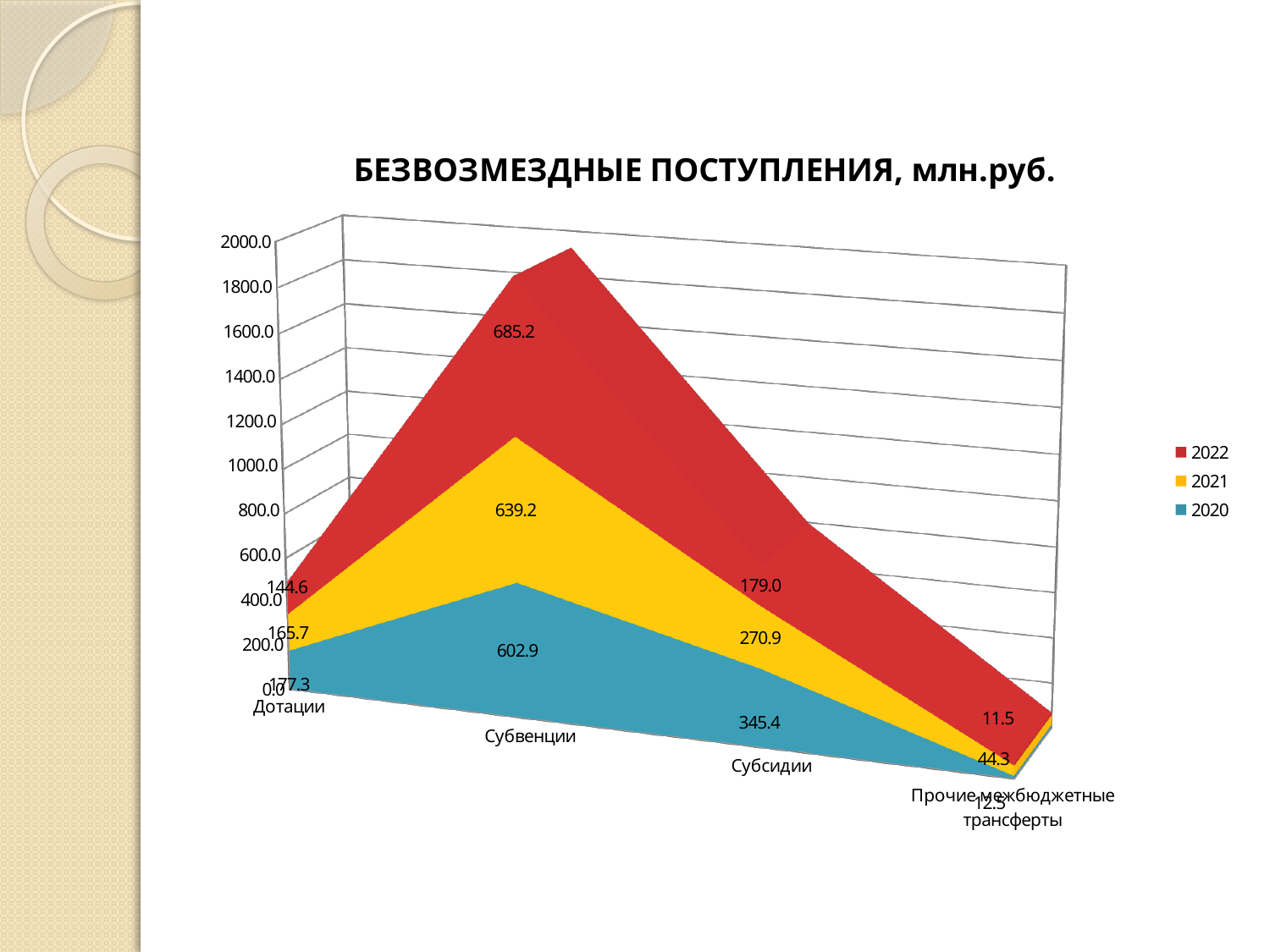
What is the 2022 value for Субвенции? 685.2 What kind of chart is shown on the slide? Area chart What is the 2020 value for Субсидии? 345.4 What is the title of the chart? БЕЗВОЗМЕЗДНЫЕ ПОСТУПЛЕНИЯ, млн.руб. For Дотации, which year has the larger value, 2020 or 2022? 2020 What is the difference between the 2020 and 2021 values for Субсидии? 74.5 What is the difference between the 2022 and 2021 values for Субвенции? 46.0 How many series does the legend list? 3 Which category has the lowest 2021 value? Прочие межбюджетные трансферты How many categories are shown on the x axis? 4 What is the 2021 value for Дотации? 165.7 Which category has the highest 2022 value? Субвенции